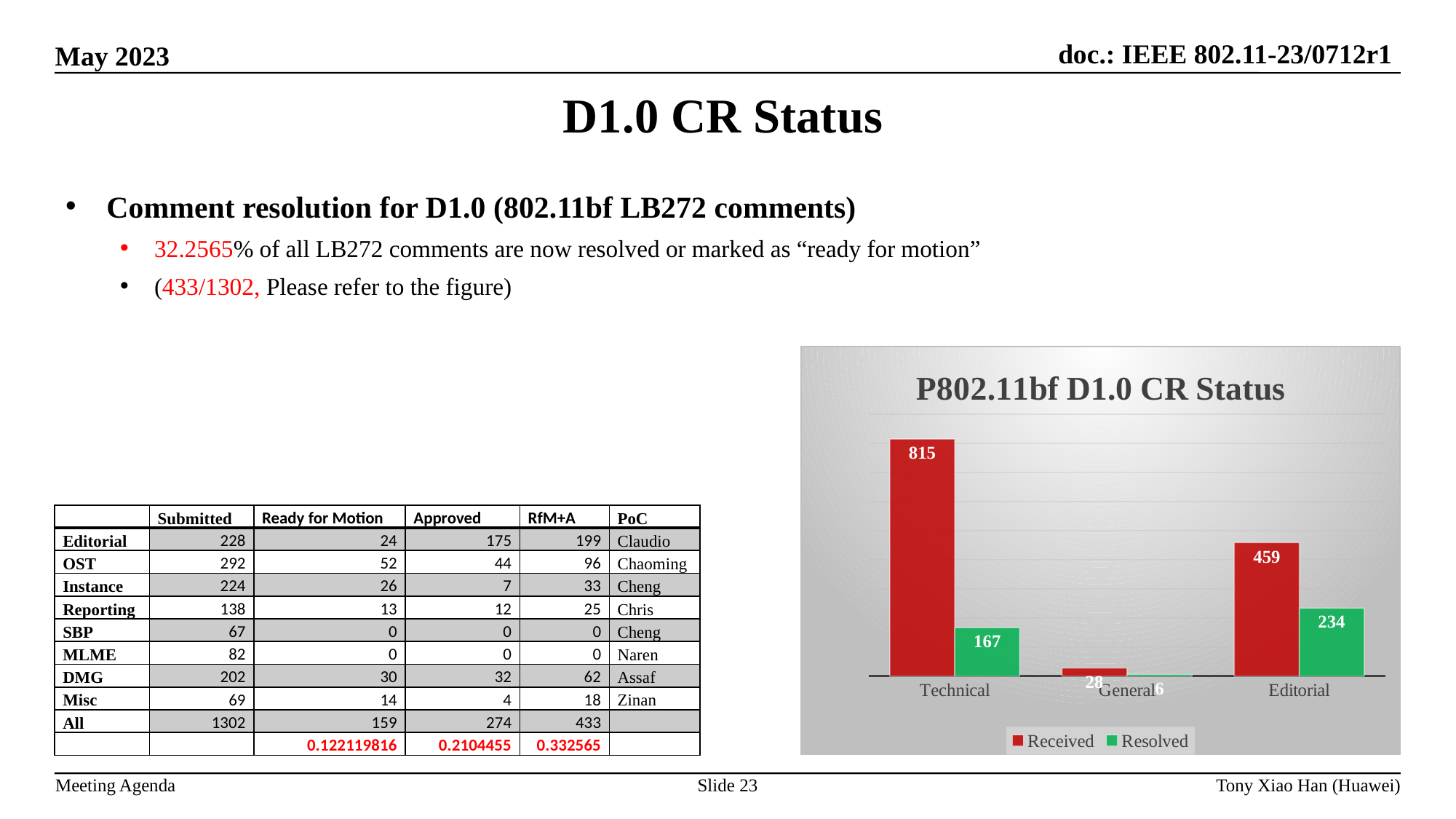
What type of chart is shown on the slide? bar chart Which category has the highest Received value? Technical Which is larger, the Resolved value for Editorial or the Resolved value for Technical? Editorial How many categories are shown on the x axis of the chart? 3 What is the title of the chart on the slide? P802.11bf D1.0 CR Status What is the Received value for Editorial? 459 What is the Resolved value for Technical? 167 What is the Resolved value for Editorial? 234 Which category has the lowest Resolved value? General How many series does the chart legend list? 2 What is the difference between the Received and Resolved values for Technical? 648 What is the Received value for Technical? 815